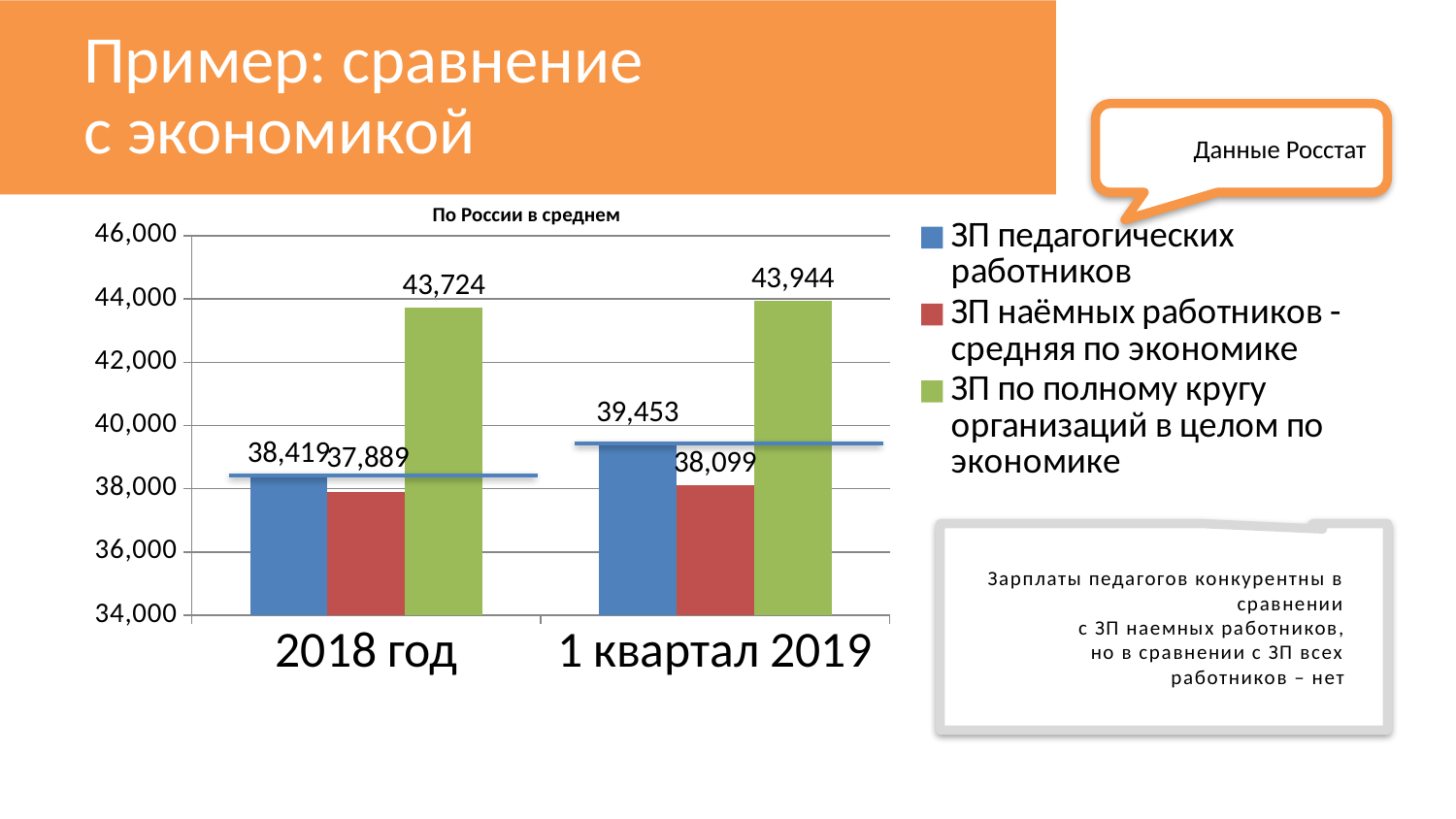
What kind of chart is shown on the slide? bar chart What is the value for ЗП педагогических работников in 1 квартал 2019? 39,453 Which is larger in 2018 год: ЗП педагогических работников or ЗП наёмных работников - средняя по экономике? ЗП педагогических работников Which series has the highest value in 1 квартал 2019? ЗП по полному кругу организаций в целом по экономике Does the value for ЗП педагогических работников rise or fall from 2018 год to 1 квартал 2019? rise Which series has the lowest value in 2018 год? ЗП наёмных работников - средняя по экономике How many categories are shown on the x axis? 2 How many series does the legend list? 3 What is the value for ЗП педагогических работников in 2018 год? 38,419 What is the value for ЗП наёмных работников - средняя по экономике in 1 квартал 2019? 38,099 What is the value for ЗП по полному кругу организаций в целом по экономике in 2018 год? 43,724 What is the difference between ЗП по полному кругу организаций в целом по экономике and ЗП педагогических работников in 1 квартал 2019? 4,491